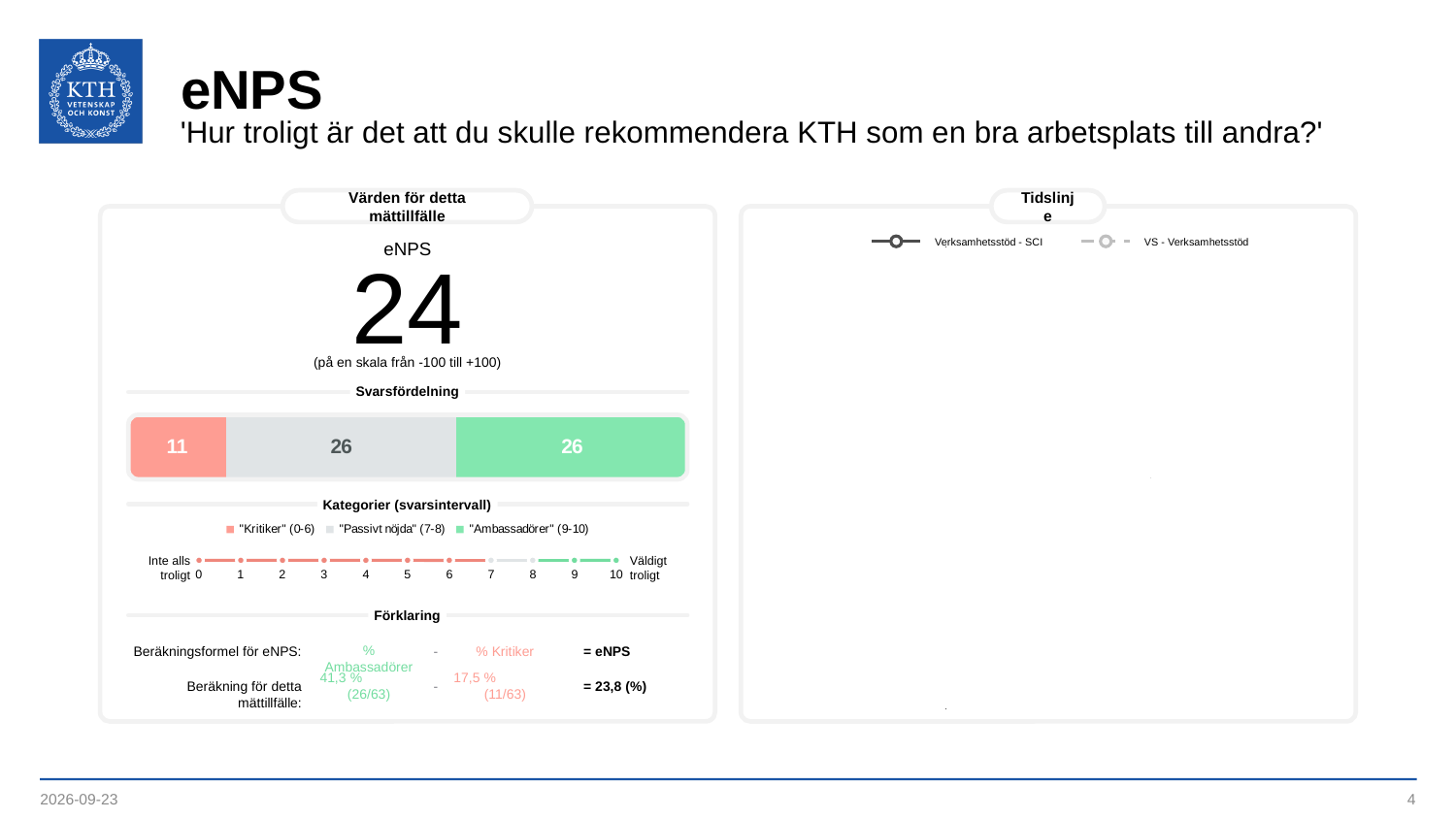
How many categories are shown in the Svarsfördelning bar? 3 In the Svarsfördelning bar, how many respondents are in the "Kritiker" (0-6) category? 11 What is the total number of respondents across all segments of the Svarsfördelning bar? 63 In the Svarsfördelning bar, which category has the fewest respondents? "Kritiker" (0-6) What kind of chart is the Svarsfördelning visual? Stacked bar chart What eNPS value is displayed for this measurement occasion? 24 In the Svarsfördelning bar, which is larger: the number of Ambassadörer or the number of Kritiker? Ambassadörer In the Svarsfördelning bar, how many respondents are in the "Ambassadörer" (9-10) category? 26 In the Svarsfördelning bar, how many respondents are in the "Passivt nöjda" (7-8) category? 26 According to the Förklaring section, what percentage of respondents are Ambassadörer? 41,3 % In the Svarsfördelning bar, what is the difference between the number of Ambassadörer and the number of Kritiker? 15 How many series does the legend of the Tidslinje chart list? 2